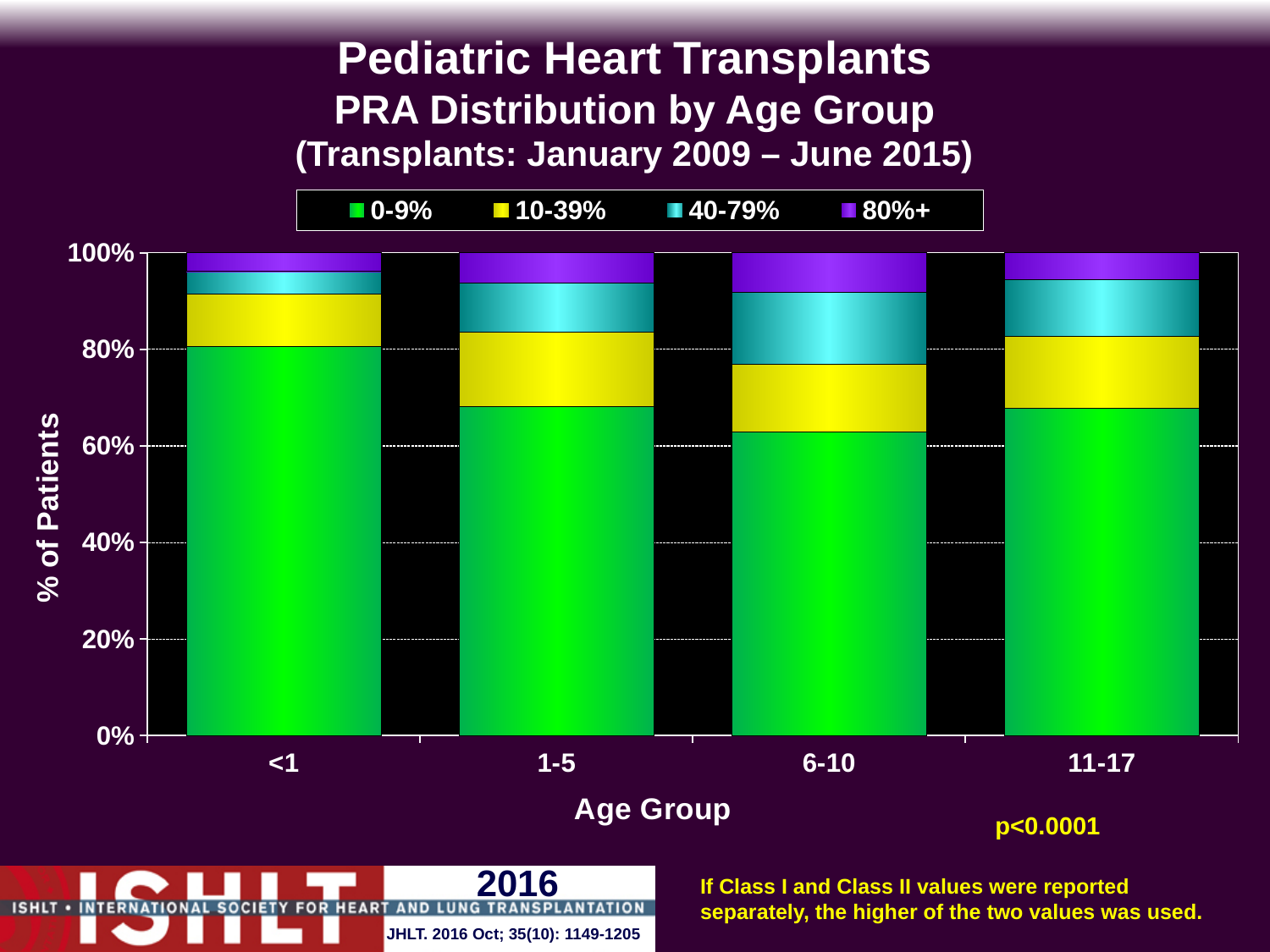
What type of chart is shown on the slide? Stacked bar chart Which age group has a larger 0-9% PRA share, <1 or 6-10? <1 Which age group has the smallest 0-9% PRA share? 6-10 Which age group has a larger 40-79% PRA share, <1 or 6-10? 6-10 What is the total of the stacked bar for the <1 age group? 100% Is the 0-9% PRA share for the 1-5 age group greater or less than 60%? greater How many age groups are shown on the x axis? 4 Which age group has the largest 0-9% PRA share? <1 What is the label on the y axis of the chart? % of Patients Is the 0-9% PRA share for the 11-17 age group greater or less than 80%? less Is the 0-9% PRA share for the 6-10 age group greater or less than 80%? less How many PRA categories does the legend list? 4